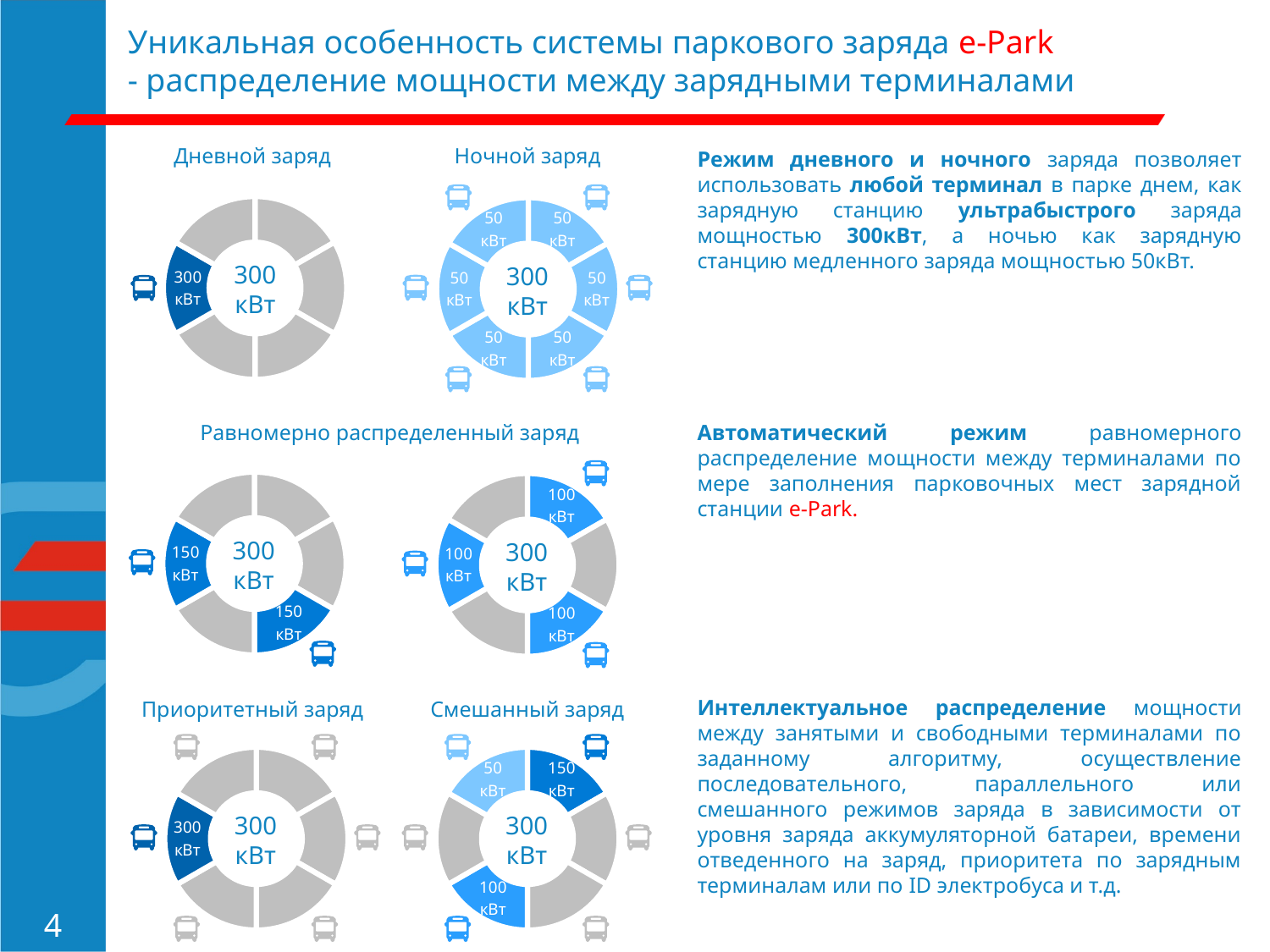
In the left "Равномерно распределенный заряд" chart, what value is shown in each highlighted segment? 150 кВт What kind of chart is used for "Ночной заряд"? Donut (pie) chart In the "Ночной заряд" chart, what value is shown in each highlighted segment? 50 кВт What value is shown in the center of the "Дневной заряд" chart? 300 кВт In the right "Равномерно распределенный заряд" chart, how many segments are highlighted with a value? 3 In the "Приоритетный заряд" chart, what value is shown in the highlighted segment? 300 кВт In the "Смешанный заряд" chart, which highlighted segment has the smallest value? 50 кВт In the "Смешанный заряд" chart, what is the difference between the 150 кВт segment and the 50 кВт segment? 100 кВт In the right "Равномерно распределенный заряд" chart, what is the total of the three highlighted segments (100 кВт each)? 300 кВт In the "Смешанный заряд" chart, which highlighted segment has the largest value? 150 кВт How many segments does the "Ночной заряд" chart have? 6 In the "Дневной заряд" chart, what value is shown in the single highlighted segment? 300 кВт